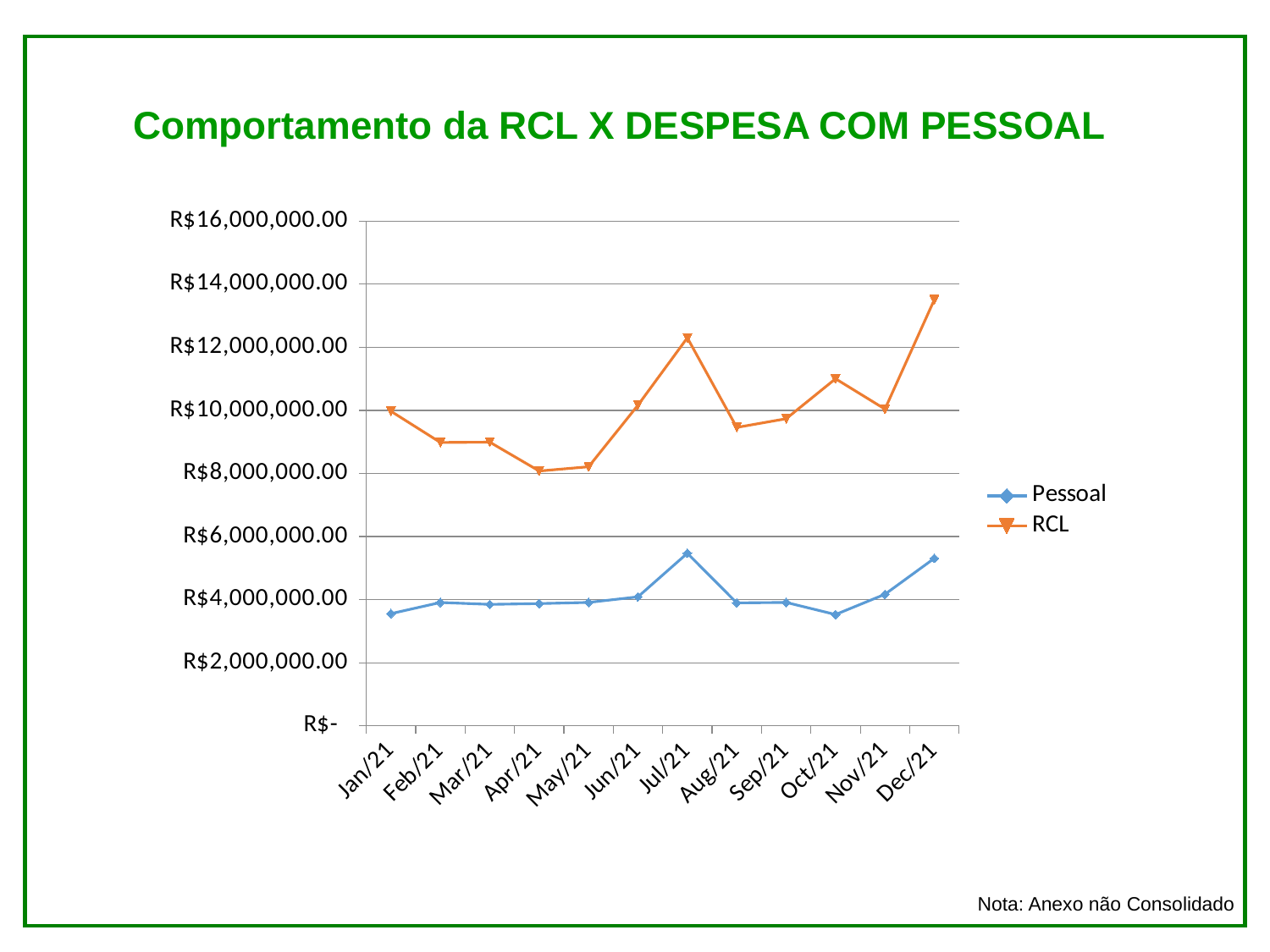
What kind of chart is shown on the slide? Line chart Is the RCL value for Apr/21 greater or less than R$10,000,000.00? less Is the Pessoal value for Jul/21 greater or less than R$4,000,000.00? greater What is the title of the chart? Comportamento da RCL X DESPESA COM PESSOAL How many months are plotted along the x axis? 12 In which month does the RCL series reach its highest value? Dec/21 Which month has the larger RCL value, Jul/21 or Aug/21? Jul/21 How many series does the legend list? 2 Is the RCL value for Dec/21 greater or less than R$12,000,000.00? greater Does the RCL series rise or fall from Jan/21 to Apr/21? Fall Which series has the larger value in Jul/21, Pessoal or RCL? RCL